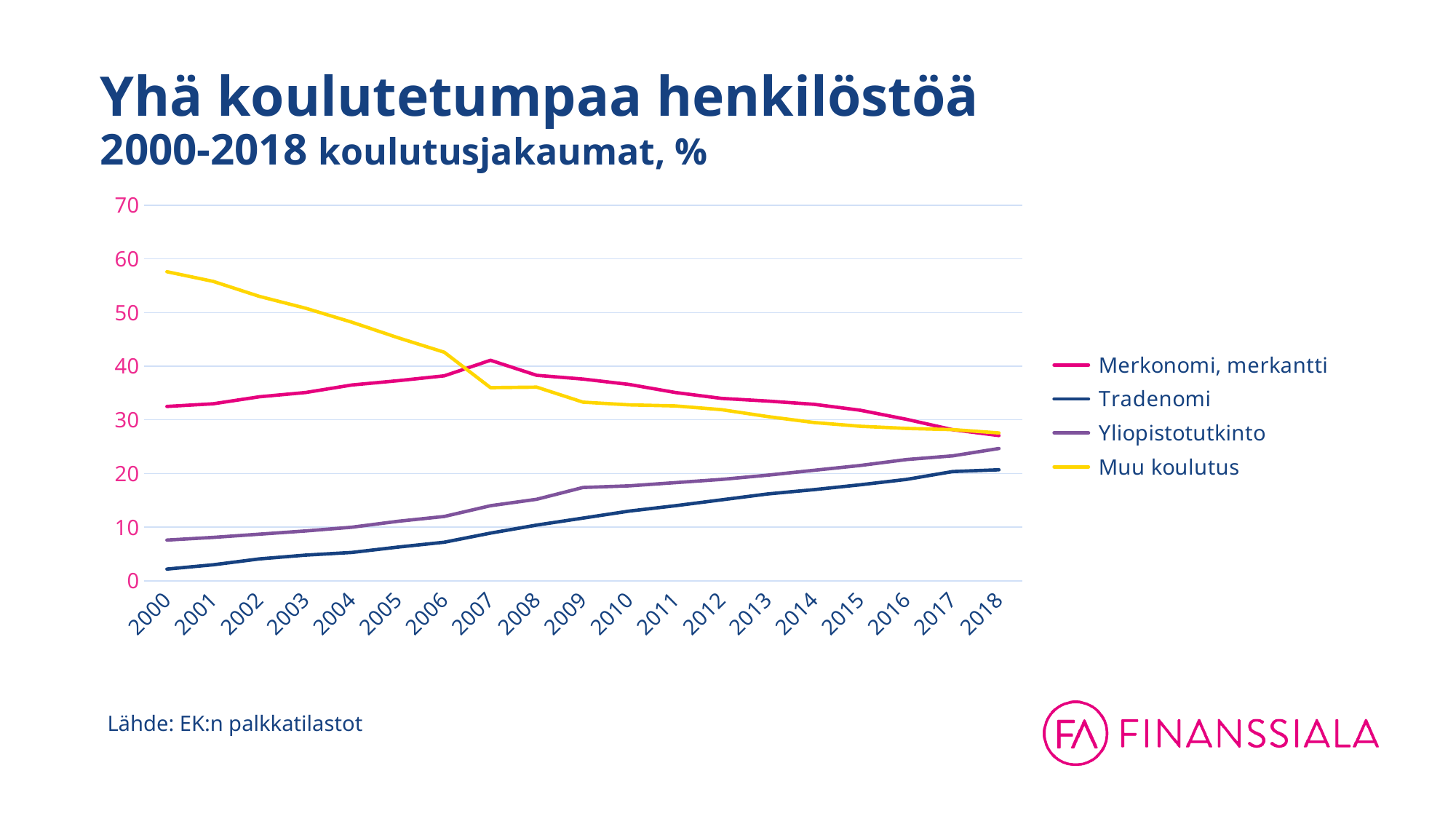
How many years are shown on the x axis? 19 What colour is the Muu koulutus line? yellow Which series has the highest value in 2000? Muu koulutus Is the value for Tradenomi in 2000 greater or less than 10? less Which series has the lowest value in 2018? Tradenomi Is the value for Yliopistotutkinto in 2018 greater or less than 20? greater How many series does the legend list? 4 Is the value for Muu koulutus in 2000 greater or less than 50? greater What kind of chart is shown on the slide? line chart Does the Tradenomi line rise or fall from 2000 to 2018? rise In 2010, which is higher: Merkonomi, merkantti or Muu koulutus? Merkonomi, merkantti Does the Muu koulutus line rise or fall from 2000 to 2018? fall